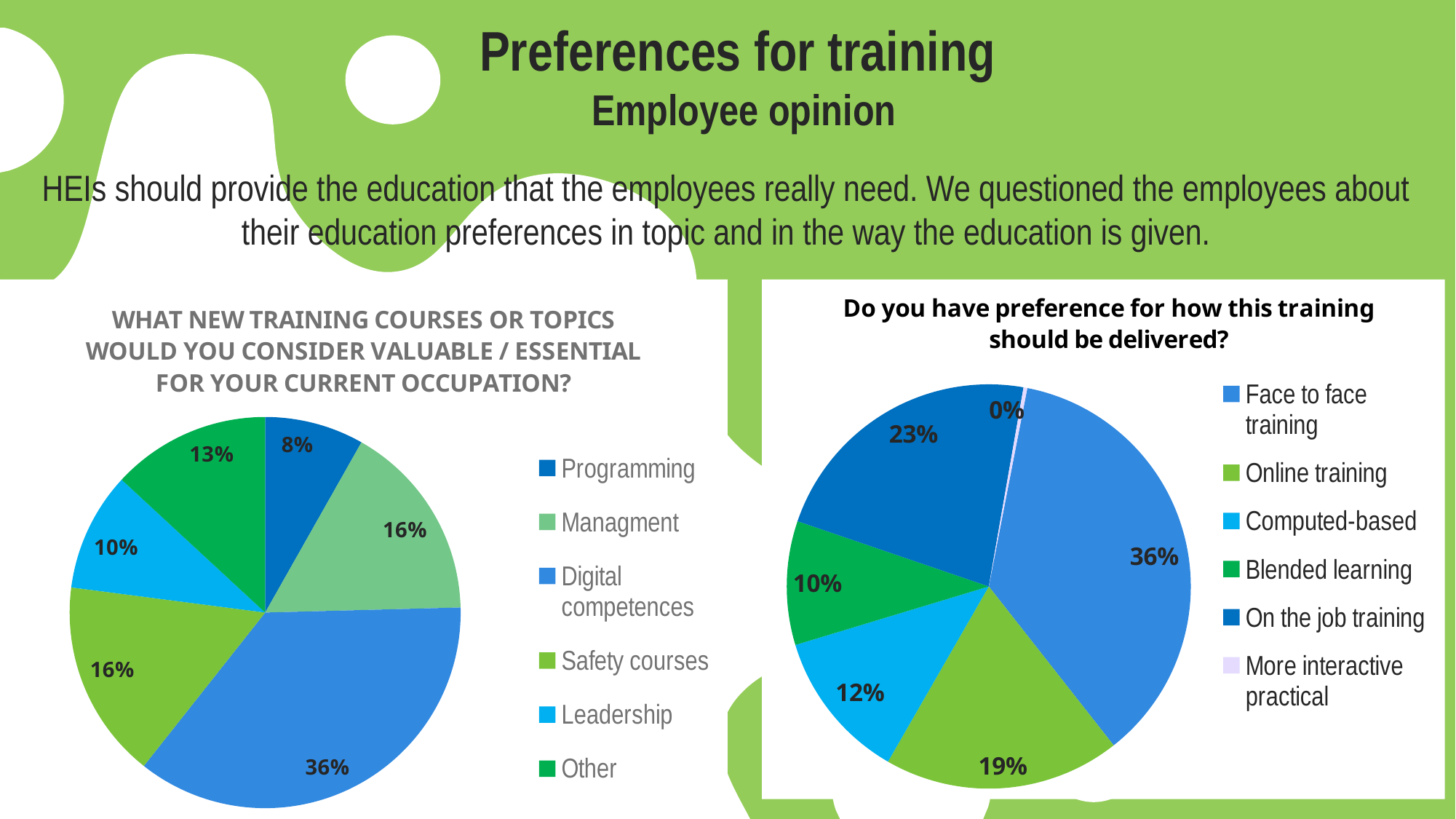
In the left pie chart about valuable training courses or topics, what share is Programming? 8% In the left pie chart about valuable training courses or topics, what is the difference in percentage points between Digital competences and Leadership? 26 In the left pie chart about valuable training courses or topics, which category has the smallest share? Programming In the left pie chart about valuable training courses or topics, what share is Digital competences? 36% In the right pie chart about how training should be delivered, what share is On the job training? 23% What type of chart is used on the right side of the slide for the question about how training should be delivered? Pie chart In the left pie chart about valuable training courses or topics, which is larger, Other or Leadership? Other In the right pie chart about how training should be delivered, which category is shown with 0%? More interactive practical In the right pie chart about how training should be delivered, which category has the largest share? Face to face training In the left pie chart about valuable training courses or topics, how many categories does the legend list? 6 In the right pie chart about how training should be delivered, what share is Face to face training? 36% In the right pie chart about how training should be delivered, what is the difference in percentage points between Online training and Computed-based? 7